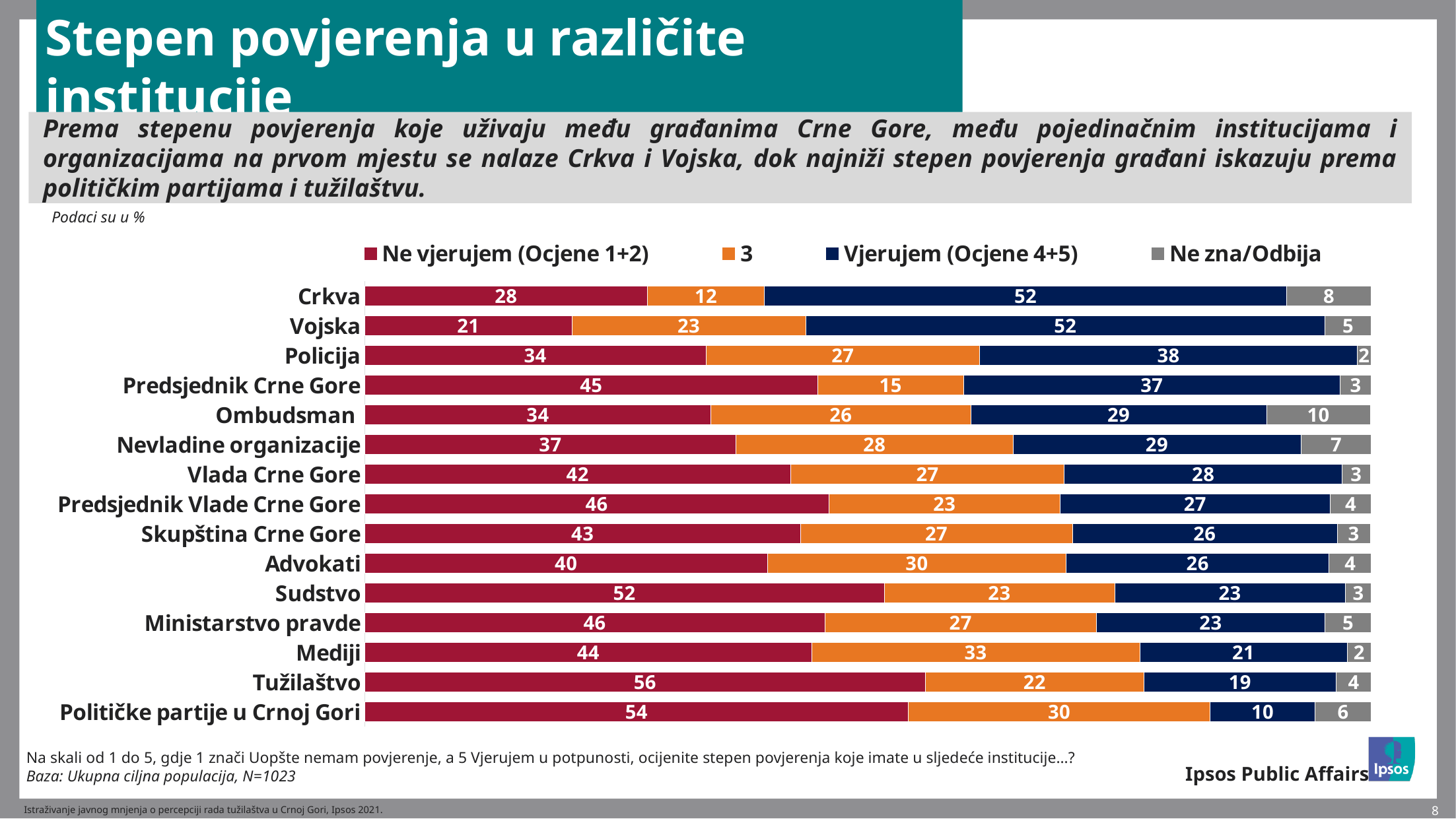
Which is larger: the 'Vjerujem (Ocjene 4+5)' value for Predsjednik Crne Gore or for Vlada Crne Gore? Predsjednik Crne Gore What is the 'Ne vjerujem (Ocjene 1+2)' value for Sudstvo? 52 How many institutions (categories) are listed in the chart? 15 Which institution has the highest value for the '3' series? Mediji What type of chart is shown on the slide? Stacked bar chart What is the 'Ne zna/Odbija' value for Ombudsman? 10 Which institution has the highest 'Ne vjerujem (Ocjene 1+2)' value? Tužilaštvo Which institution has the lowest 'Vjerujem (Ocjene 4+5)' value? Političke partije u Crnoj Gori What is the difference between the 'Ne vjerujem (Ocjene 1+2)' values for Tužilaštvo and Crkva? 28 What is the total of the stacked bar for Političke partije u Crnoj Gori? 100 How many series does the legend list? 4 What is the 'Vjerujem (Ocjene 4+5)' value for Policija? 38